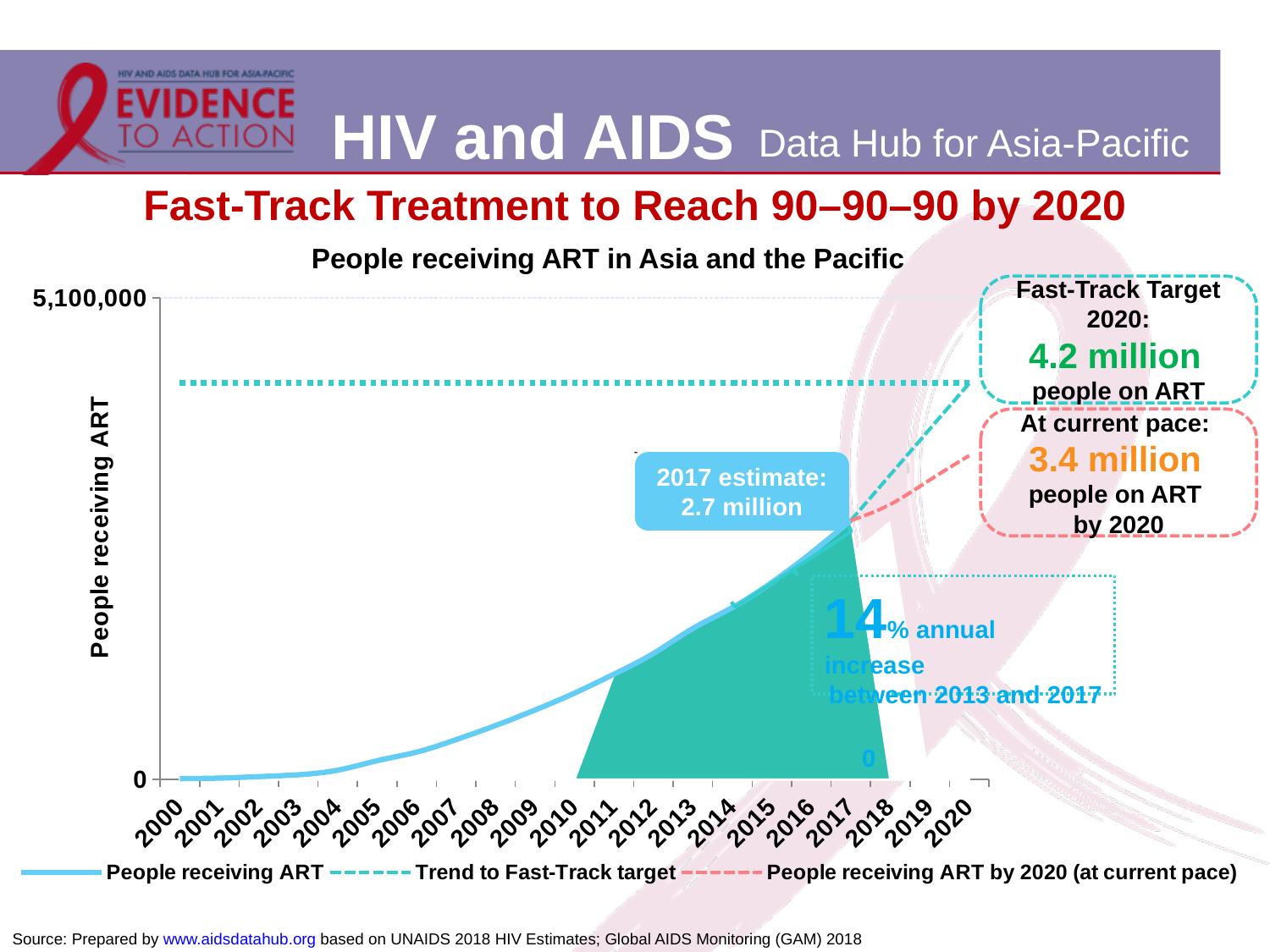
How many series does the chart legend list? 3 According to the chart annotation, what is the 2017 estimate of people receiving ART? 2.7 million What is the first year shown on the x axis? 2000 Does the number of people receiving ART rise or fall from 2000 to 2017? rise What type of chart is shown on the slide? line chart What is the highest value shown on the y axis? 5,100,000 Which is larger: the Fast-Track Target for 2020 or the projection at current pace for 2020? Fast-Track Target for 2020 At the current pace, how many people are projected to be on ART by 2020? 3.4 million What is the title of the chart? People receiving ART in Asia and the Pacific What is the difference between the Fast-Track Target for 2020 and the projection at current pace for 2020? 0.8 million What is the Fast-Track Target for people on ART in 2020? 4.2 million What annual increase in people receiving ART is noted between 2013 and 2017? 14%